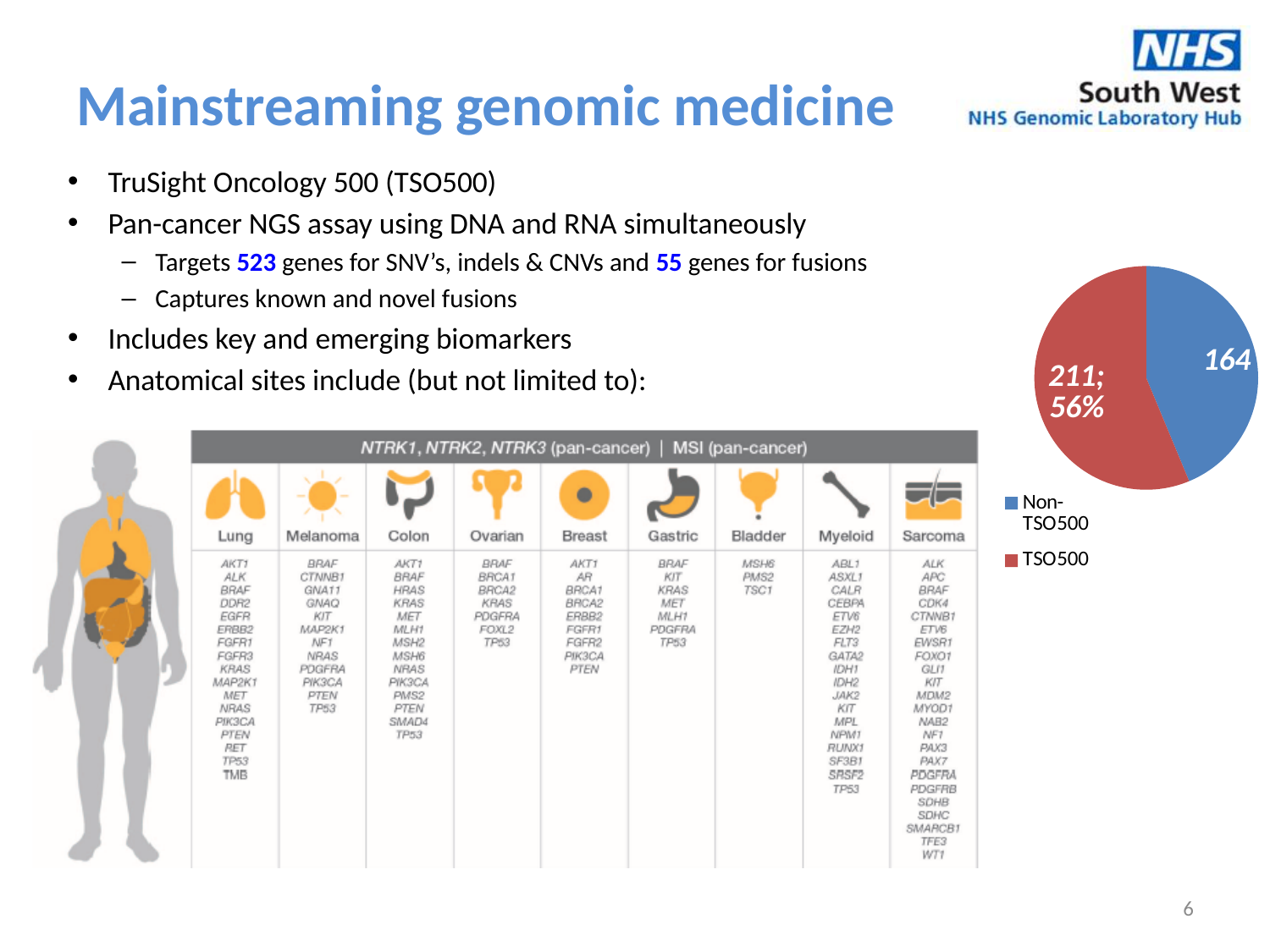
Which slice of the pie chart is the largest? TSO500 In the pie chart, what is the value for Non-TSO500? 164 How many slices does the pie chart have? 2 What is the total of the two values shown in the pie chart? 375 How many entries does the pie chart's legend list? 2 Which slice of the pie chart is the smallest? Non-TSO500 What kind of chart is shown on the right side of the slide? Pie chart In the pie chart, which is larger: TSO500 or Non-TSO500? TSO500 In the pie chart, what is the difference between the TSO500 value and the Non-TSO500 value? 47 In the pie chart, what is the value for TSO500? 211 What colour is the TSO500 slice in the pie chart? Red In the pie chart, what percentage share does the TSO500 slice have? 56%